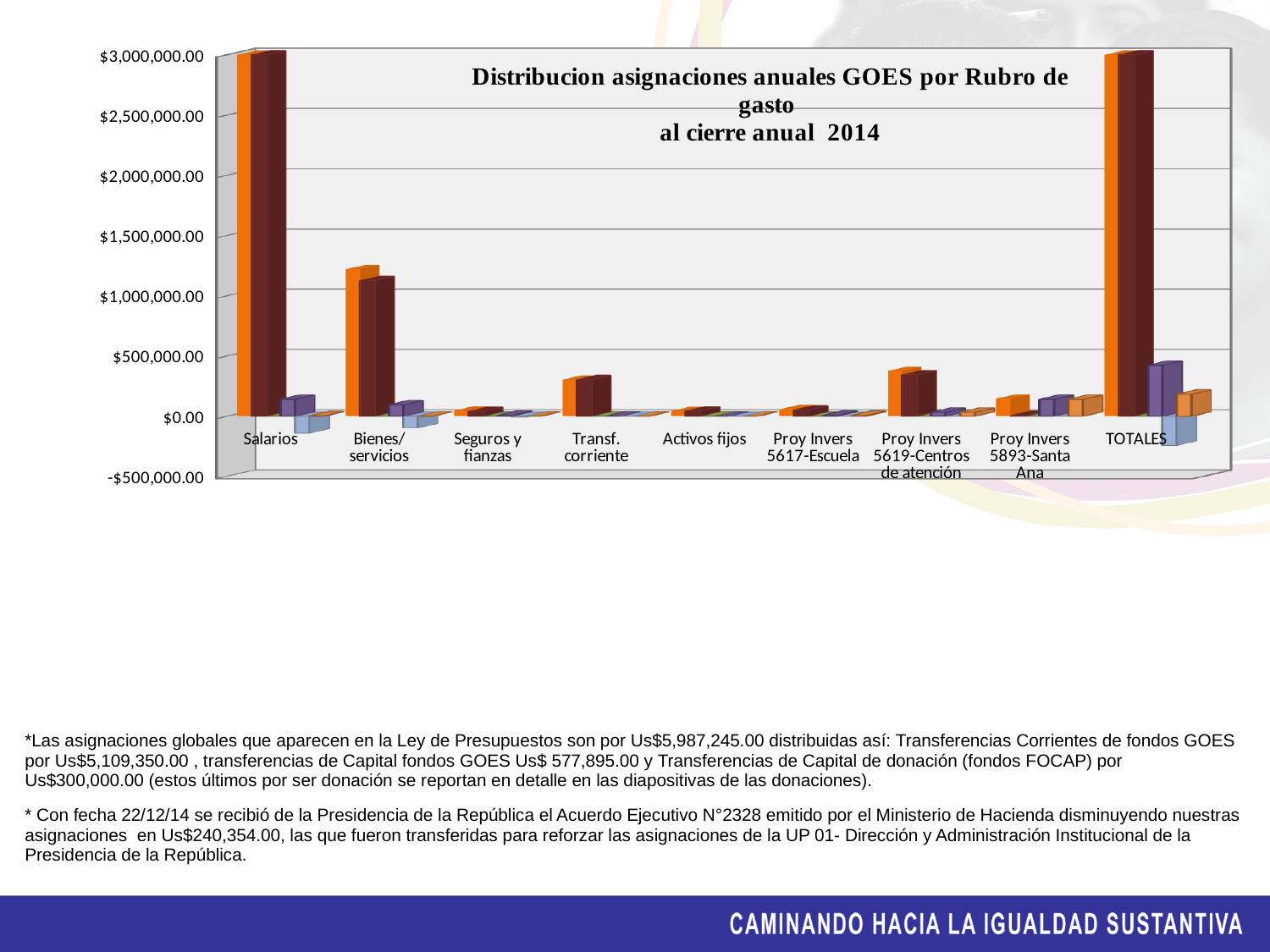
Is the tallest bar for Salarios greater or less than $2,500,000.00? greater How many categories are shown along the x axis of the chart? 9 Is the tallest bar for Seguros y fianzas greater or less than $500,000.00? less Is the tallest bar for Bienes/servicios greater or less than $1,000,000.00? greater Excluding TOTALES, which category has the tallest bar? Salarios What kind of chart is shown on the slide? bar chart Which category on the x axis comes immediately after Salarios? Bienes/servicios Which has the taller tallest bar, Proy Invers 5619-Centros de atención or Proy Invers 5617-Escuela? Proy Invers 5619-Centros de atención Which has the taller tallest bar, Bienes/servicios or Transf. corriente? Bienes/servicios What is the title of the chart? Distribucion asignaciones anuales GOES por Rubro de gasto al cierre anual 2014